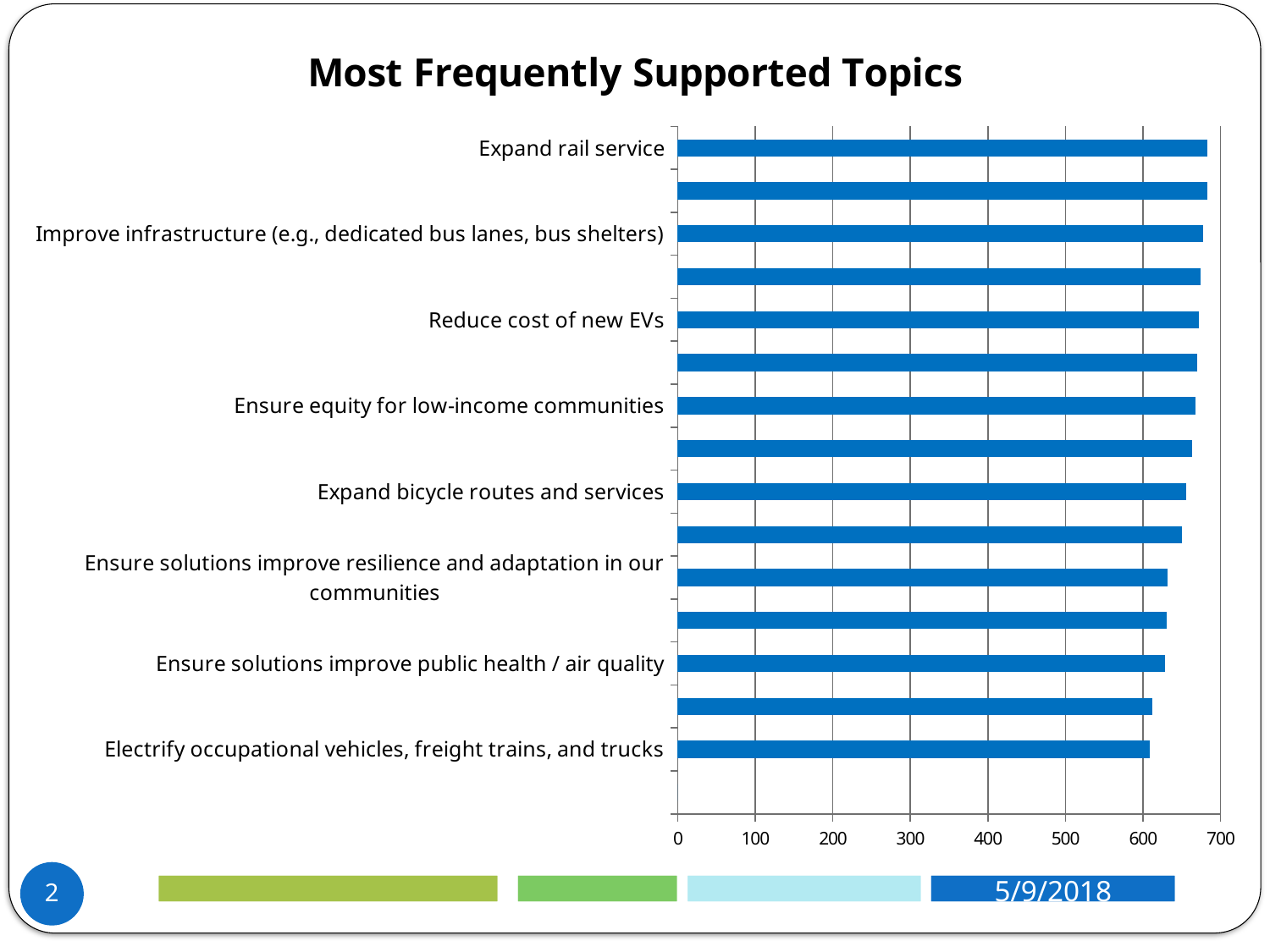
How many bars are plotted in the chart? 15 Is the value for Expand rail service greater or less than 600? greater What is the title of the chart? Most Frequently Supported Topics Which has the larger value: Expand rail service or Electrify occupational vehicles, freight trains, and trucks? Expand rail service Is the value for Electrify occupational vehicles, freight trains, and trucks greater or less than 700? less Is the value for Ensure solutions improve public health / air quality greater or less than 500? greater Do the bar values increase or decrease going from the top of the chart to the bottom? decrease What is the highest value shown on the horizontal axis? 700 Which of the labeled categories has the shortest bar? Electrify occupational vehicles, freight trains, and trucks What kind of chart is shown on the slide? Bar chart Which has the larger value: Reduce cost of new EVs or Ensure solutions improve public health / air quality? Reduce cost of new EVs